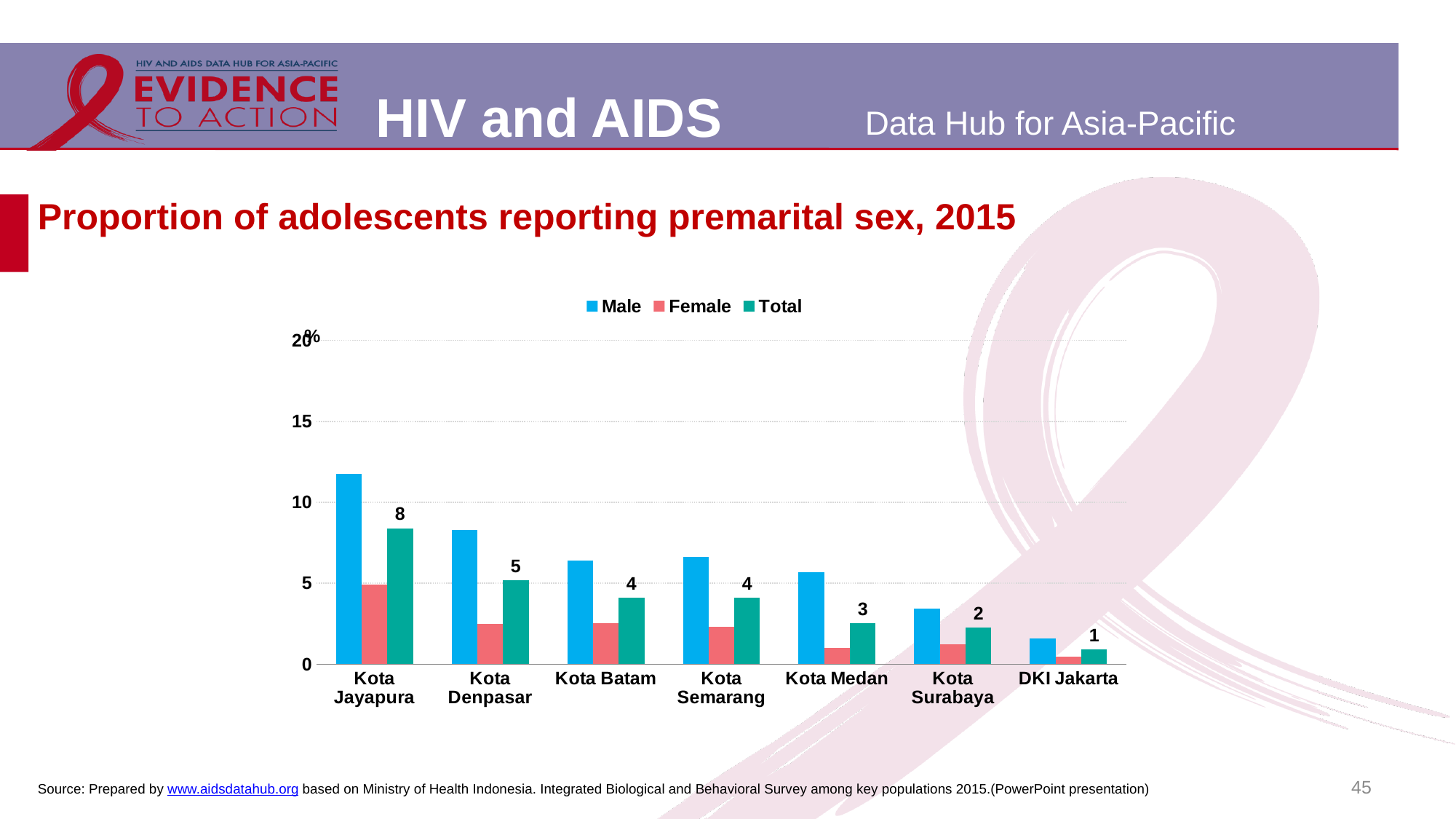
How many cities are shown on the x axis? 7 Which city has the lowest Total value? DKI Jakarta What is the Total value for DKI Jakarta? 1 In Kota Jayapura, which is larger, the Male value or the Female value? Male What is the Total value for Kota Jayapura? 8 Which city has the highest Total value? Kota Jayapura Is the Male value for Kota Jayapura greater or less than 10? greater What is the difference between the Total values for Kota Jayapura and Kota Surabaya? 6 Is the Female value for Kota Denpasar greater or less than 5? less What is the Total value for Kota Denpasar? 5 How many series does the legend list? 3 Do the Total values rise or fall from left to right across the cities? fall